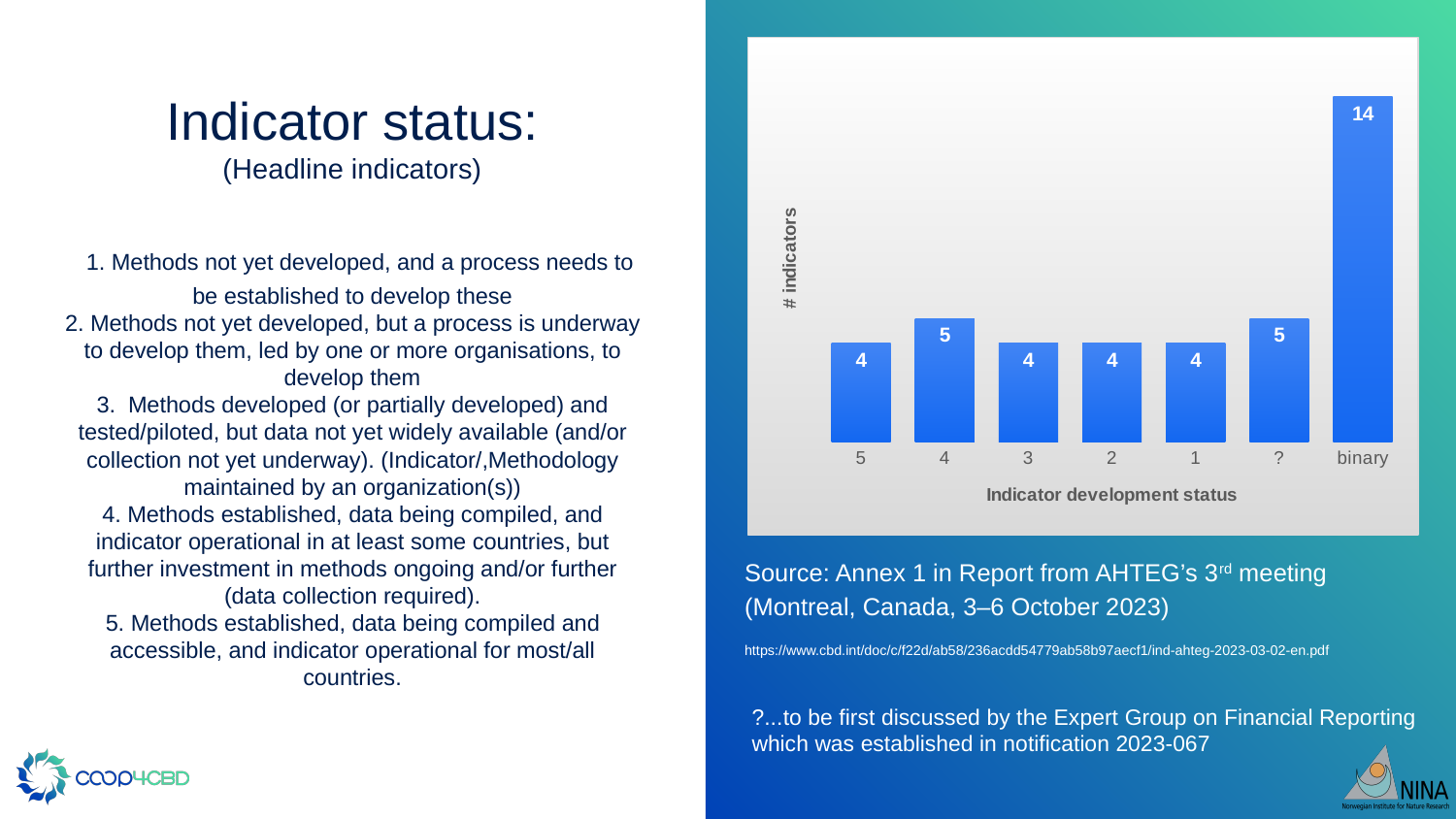
How many indicators are shown for development status 3? 4 What kind of chart is shown on the slide? bar chart What is the total of all the bar values in the chart? 40 What is the difference between the value for "?" and the value for status 1? 1 What is the value for the "?" category? 5 Which category has the highest value? binary Which is larger, the value for status 4 or the value for status 5? status 4 How many categories are shown on the x axis? 7 What is the label of the y axis? # indicators What is the value for the "binary" category? 14 What is the difference between the value for "binary" and the value for status 4? 9 What is the label of the x axis? Indicator development status